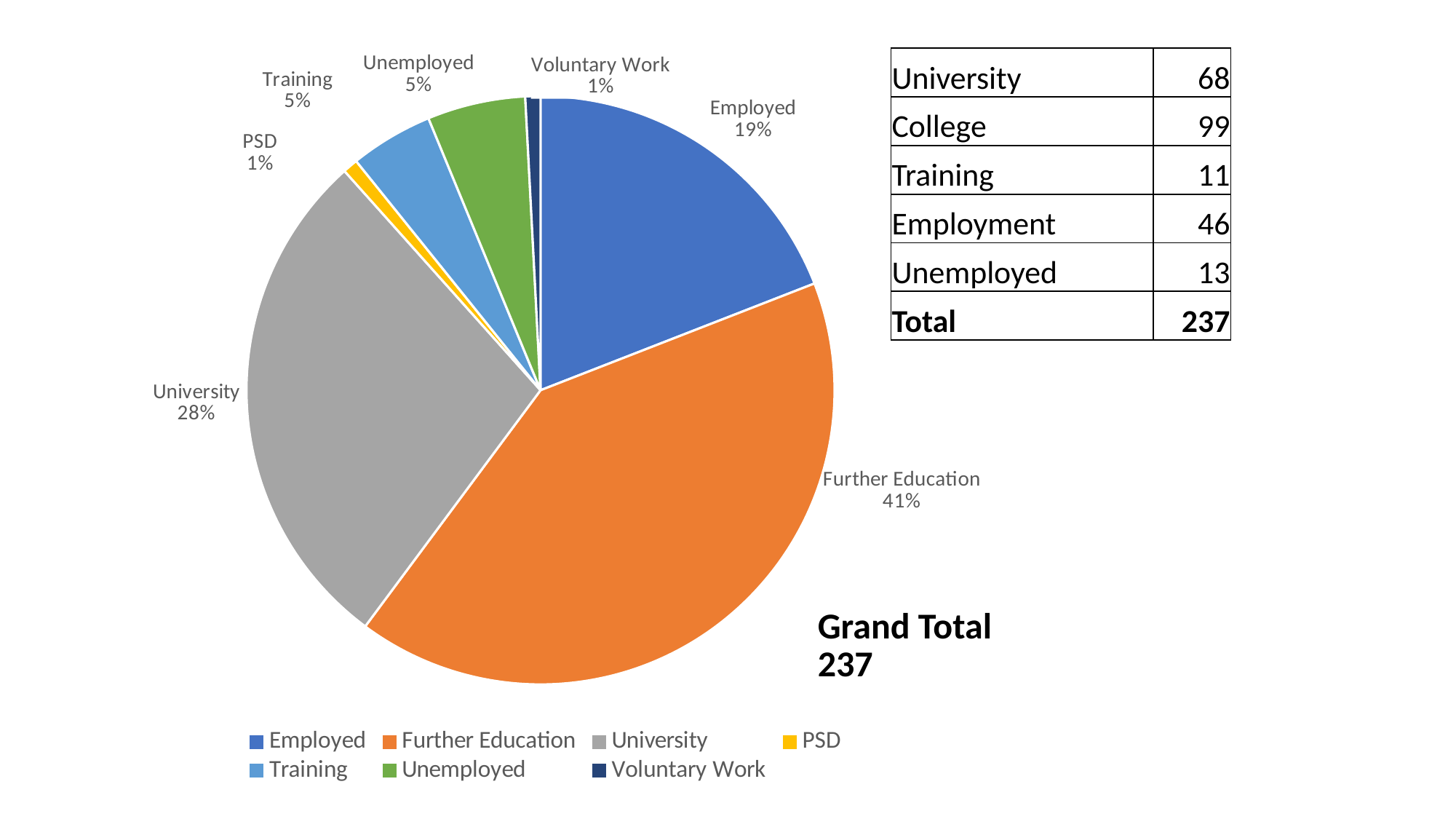
What is the Grand Total shown on the slide? 237 How many categories does the pie chart legend list? 7 What kind of chart is shown on the slide? pie chart What percentage share does Training have in the pie chart? 5% What percentage share does University have in the pie chart? 28% What colour is the Further Education slice in the pie chart? orange What percentage share does Further Education have in the pie chart? 41% Which slice is larger in the pie chart, University or Employed? University Which category has the largest slice in the pie chart? Further Education What is the difference in percentage points between the Further Education and University slices? 13%